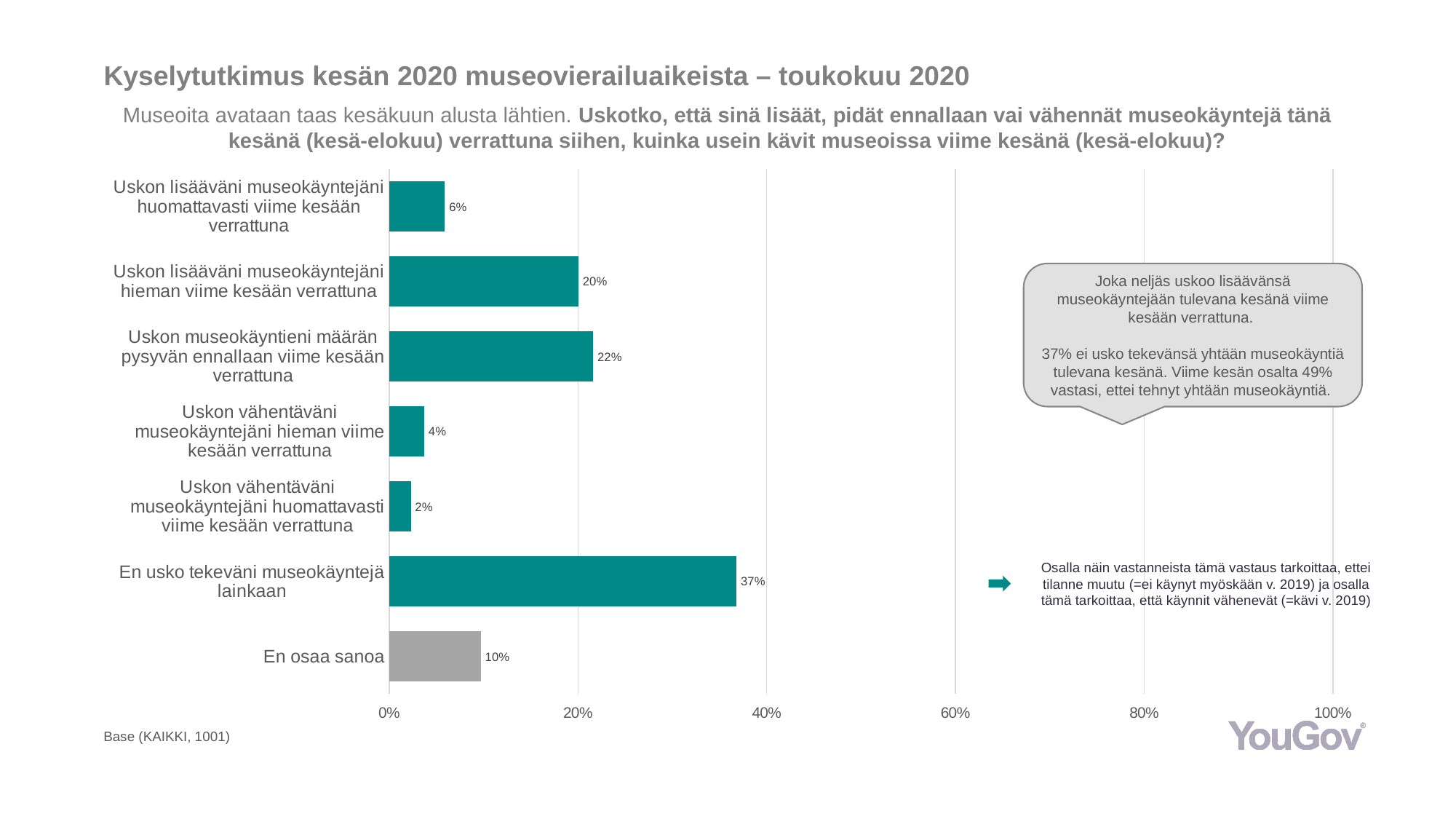
Which category has the lowest value? Uskon vähentäväni museokäyntejäni huomattavasti viime kesään verrattuna What is the value for "En usko tekeväni museokäyntejä lainkaan"? 37% Which bar is shown in a different colour (grey) from the others? En osaa sanoa Which category has the highest value? En usko tekeväni museokäyntejä lainkaan What is the difference between "Uskon museokäyntieni määrän pysyvän ennallaan viime kesään verrattuna" and "Uskon lisääväni museokäyntejäni hieman viime kesään verrattuna"? 2% What is the value for "Uskon lisääväni museokäyntejäni hieman viime kesään verrattuna"? 20% What kind of chart is shown on the slide? bar chart What is the value for "En osaa sanoa"? 10% What is the combined value of the two "Uskon lisääväni" categories? 26% How many categories are shown in the chart? 7 Is the value for "En usko tekeväni museokäyntejä lainkaan" greater or less than 40%? less Which is larger: the value for "Uskon lisääväni museokäyntejäni huomattavasti viime kesään verrattuna" or for "Uskon vähentäväni museokäyntejäni hieman viime kesään verrattuna"? Uskon lisääväni museokäyntejäni huomattavasti viime kesään verrattuna